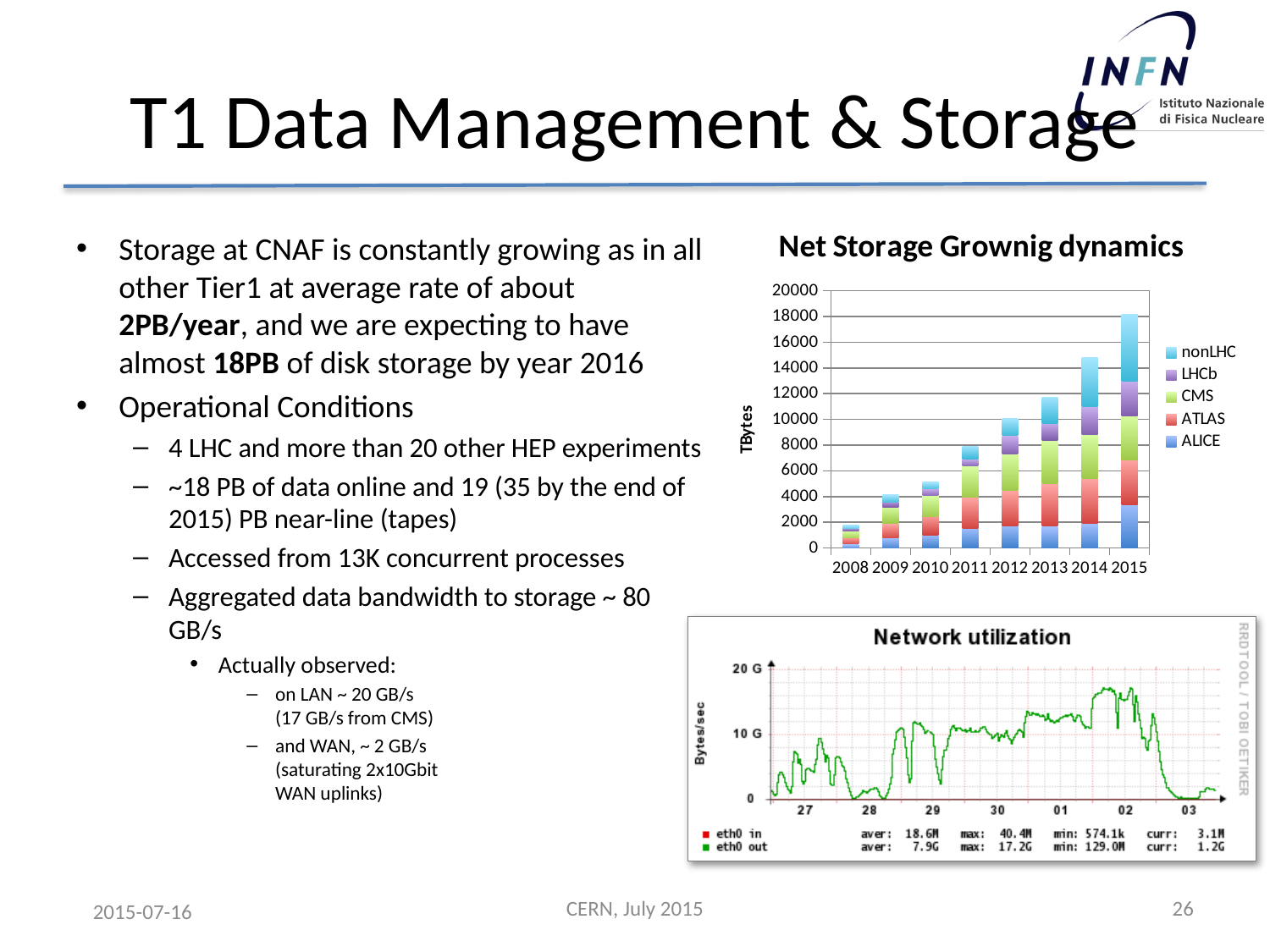
In the 'Net Storage Grownig dynamics' chart, how many years are shown on the x axis? 8 In the 'Net Storage Grownig dynamics' chart, do the stacked totals rise or fall from 2008 to 2015? rise In the 'Net Storage Grownig dynamics' chart, is the total for 2014 greater or less than 12000? greater In the 'Net Storage Grownig dynamics' chart, which year has the larger total, 2012 or 2013? 2013 In the 'Net Storage Grownig dynamics' chart, how many series does the legend list? 5 In the 'Net Storage Grownig dynamics' chart, which year has the shortest stacked bar? 2008 In the 'Net Storage Grownig dynamics' chart, what is the label on the y axis? TBytes In the 'Net Storage Grownig dynamics' chart, is the total for 2008 greater or less than 2000? less In the 'Net Storage Grownig dynamics' chart, which year has the tallest stacked bar? 2015 In the 'Network utilization' chart, what is the max value listed for eth0 out? 17.2G What kind of chart is the 'Net Storage Grownig dynamics' chart? bar chart In the 'Net Storage Grownig dynamics' chart, is the total for 2015 greater or less than 16000? greater